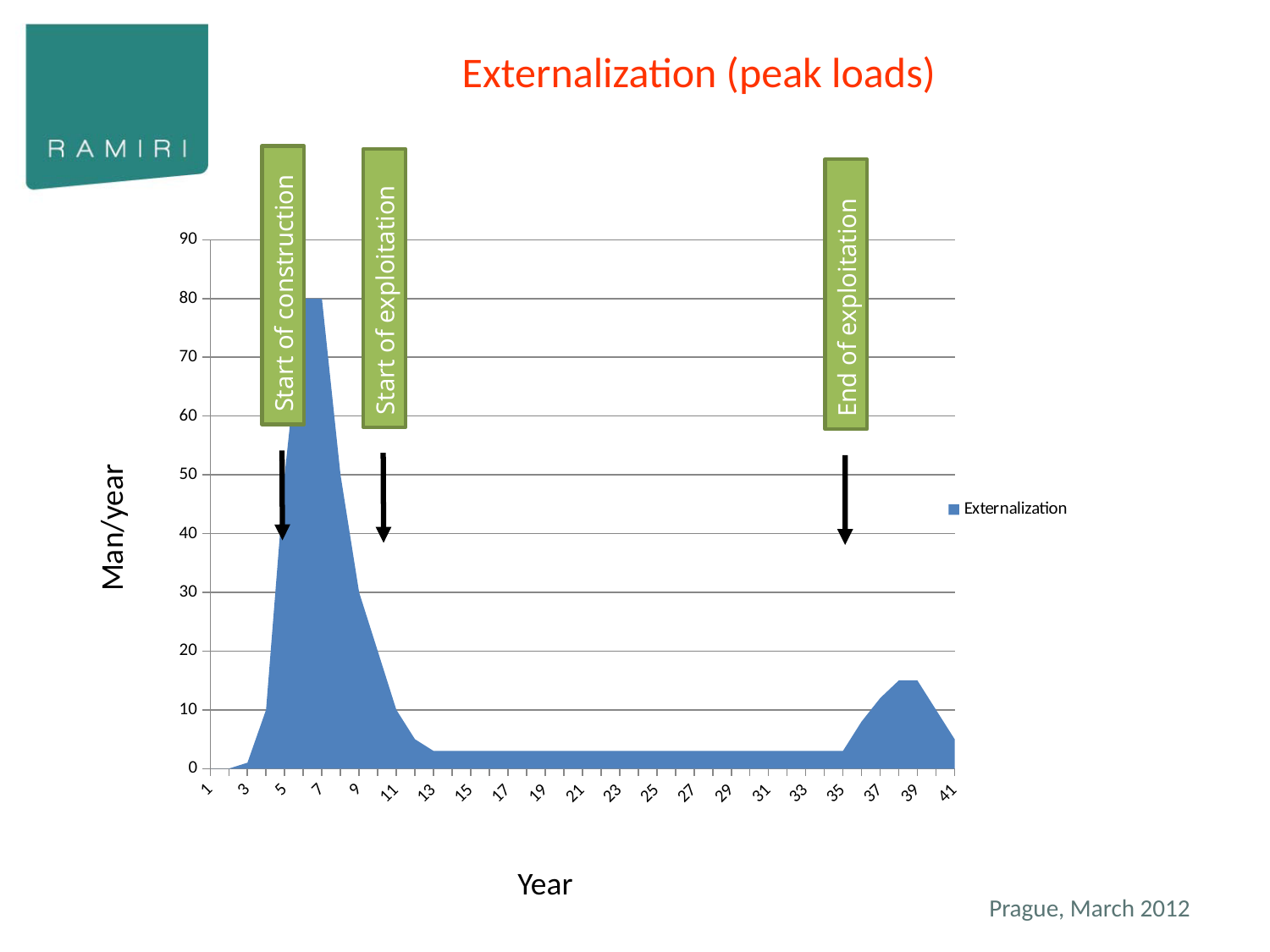
How many series does the legend list? 1 What is the title of the chart? Externalization (peak loads) Around which year does the Externalization series reach its highest value? 7 Which is larger, the value at year 7 or the value at year 39? Year 7 What kind of chart is shown on the slide? Area chart Is the peak value of the Externalization series greater or less than 70? greater Do the values rise or fall between year 7 and year 13? fall What is the label of the horizontal axis? Year Is the value for year 21 greater or less than 10? less Is the value for year 39 greater or less than 10? greater What is the label of the vertical axis? Man/year What is the name of the series shown in the legend? Externalization